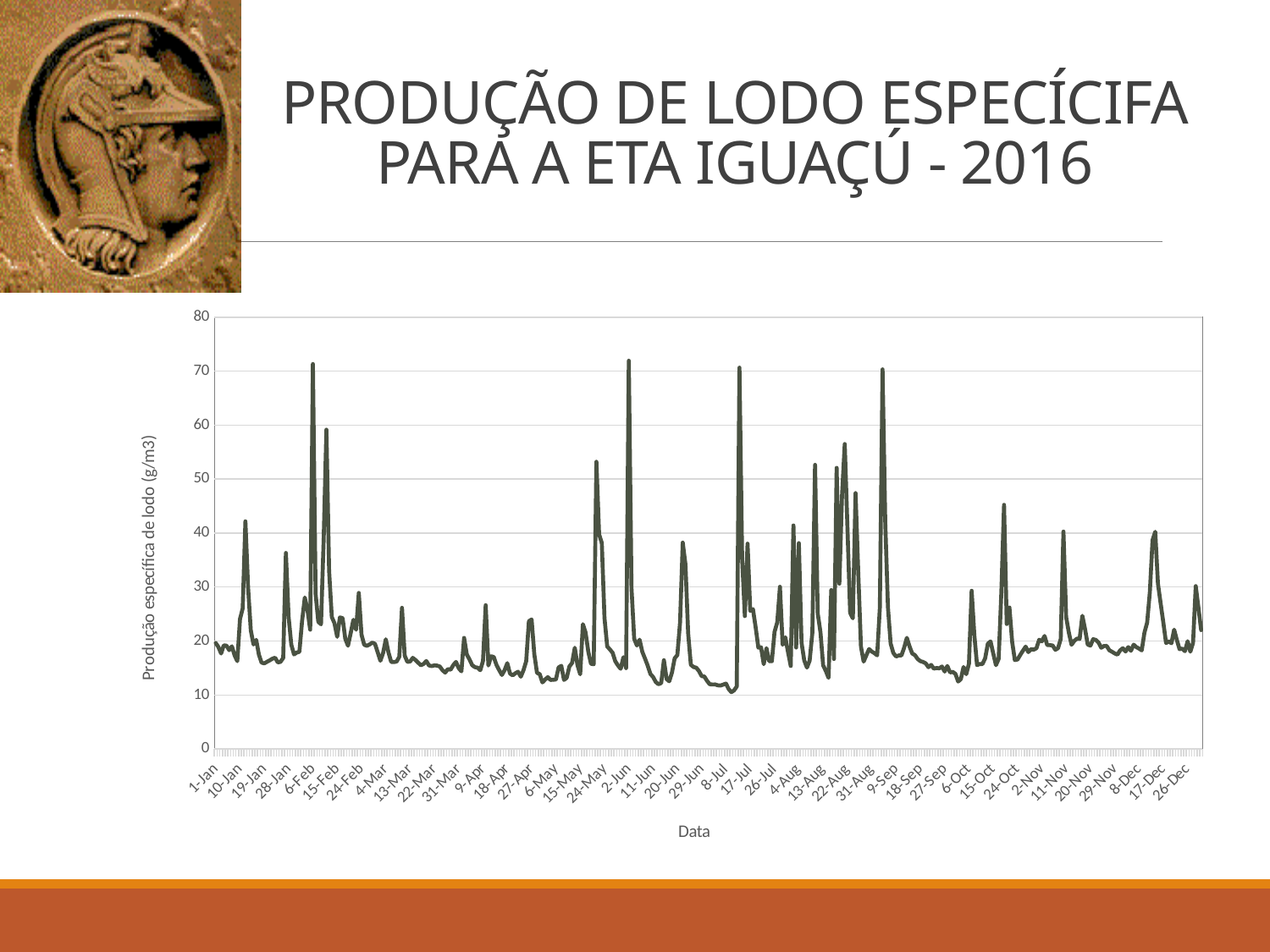
What is the title of the y axis of the chart? Produção específica de lodo (g/m3) What kind of chart is shown on the slide? line chart Is the value on 1-Jan greater or less than 10? greater Is the highest peak near 2-Jun greater or less than 60? greater Is the value around 8-Jul greater or less than 20? less How many data series are plotted in the chart? 1 What is the title of the x axis of the chart? Data